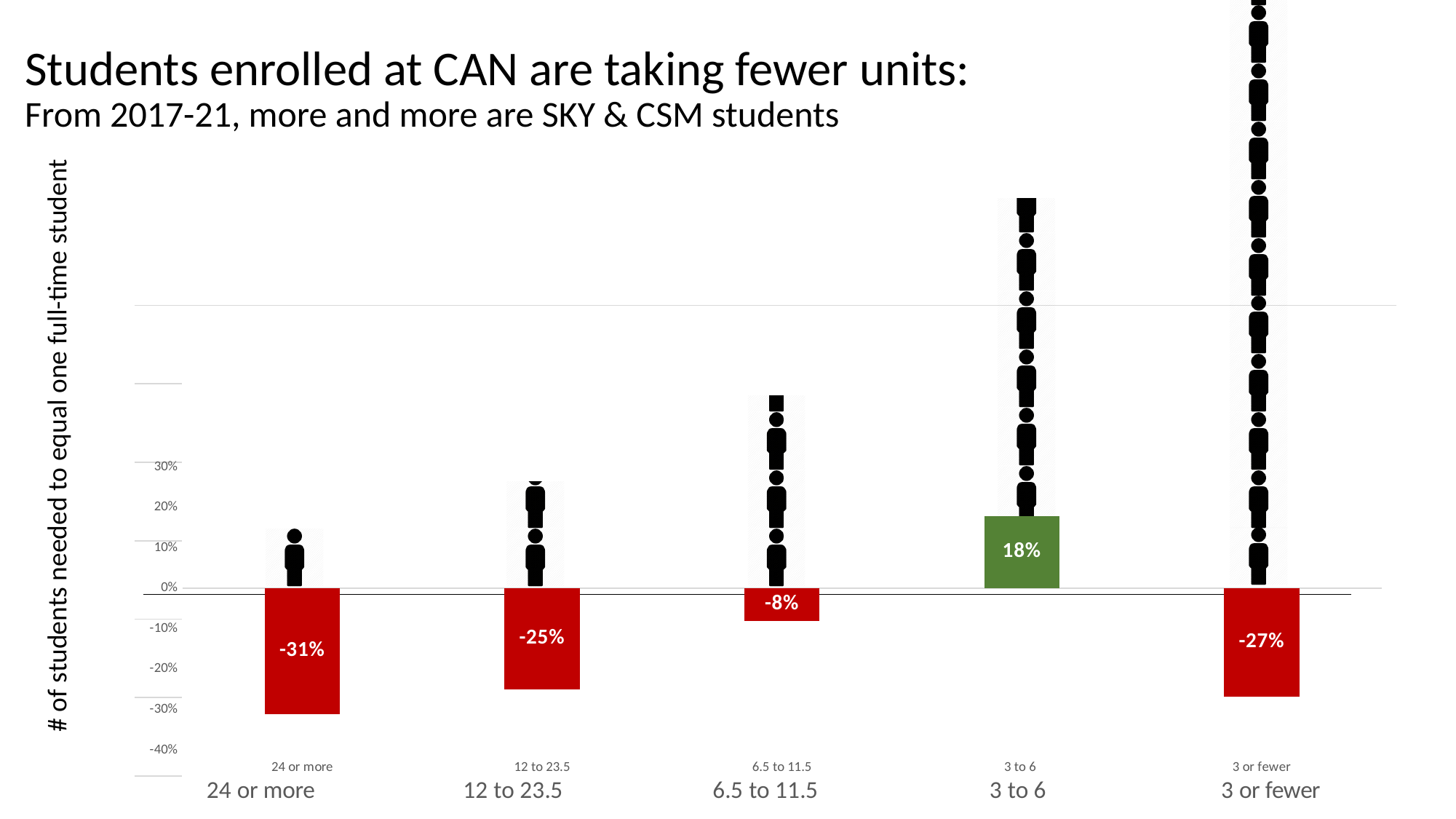
Which category has the highest value? 3 to 6 What is the value for the "3 to 6" category? 18% Is the value for "24 or more" greater or less than -30%? less Which category is the only one shown with a green bar? 3 to 6 What is the value for the "6.5 to 11.5" category? -8% Which is larger, the value for "12 to 23.5" or the value for "3 or fewer"? 12 to 23.5 What is the value for the "3 or fewer" category? -27% What is the difference between the values for "12 to 23.5" and "6.5 to 11.5"? 17 percentage points How many categories are shown on the x axis? 5 Which category has the lowest value? 24 or more What is the value for the "24 or more" category? -31% What kind of chart is shown on the slide? bar chart